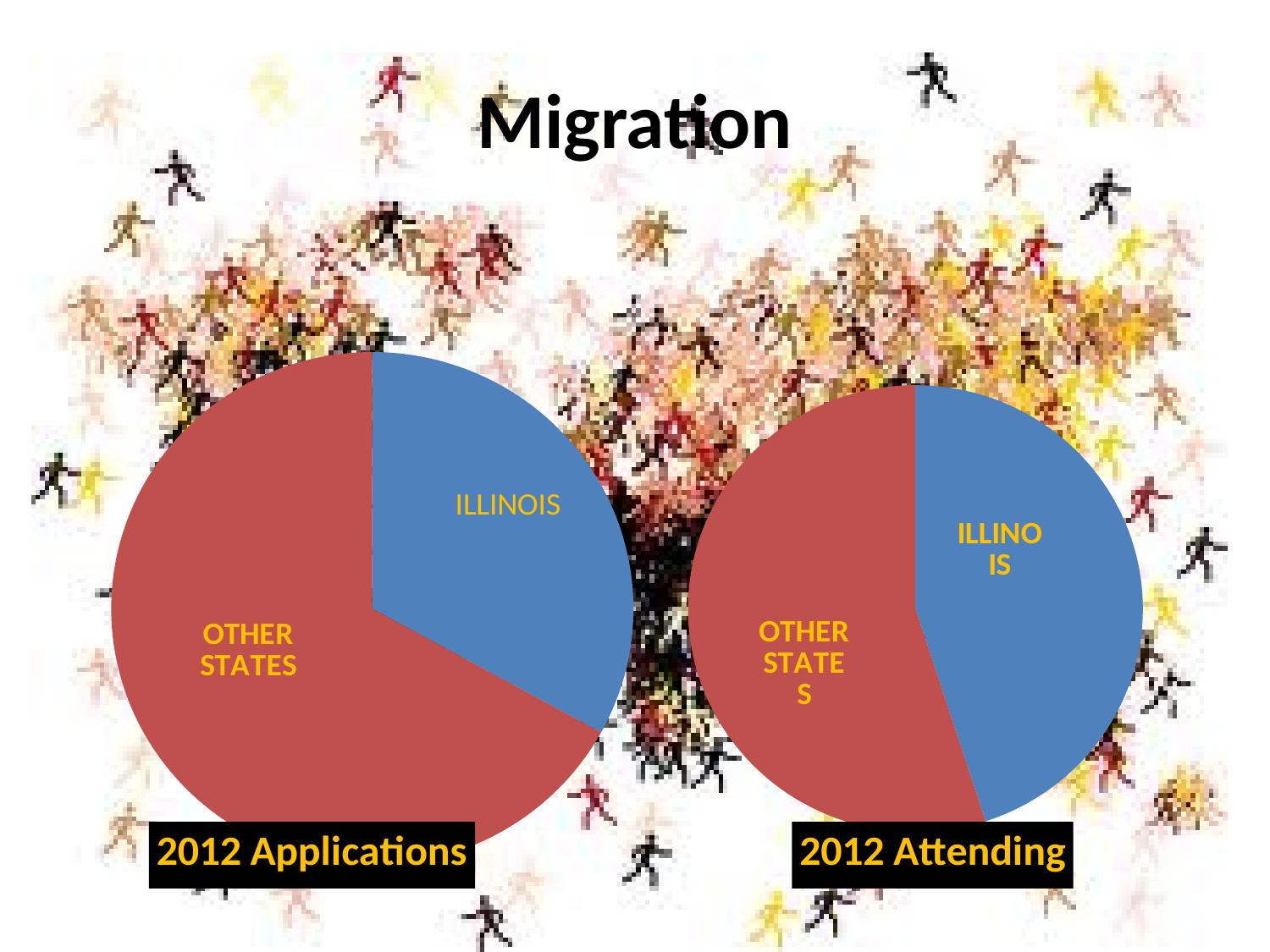
What kind of chart is the 2012 Applications chart? pie chart How many slices does the 2012 Applications pie chart have? 2 What colour is the ILLINOIS slice in the 2012 Attending pie chart? blue What is the title of the slide containing the two pie charts? Migration In the 2012 Applications pie chart, which is larger: the ILLINOIS slice or the OTHER STATES slice? OTHER STATES How many pie charts are shown on the slide? 2 In the 2012 Applications pie chart, which slice is the largest? OTHER STATES How many slices does the 2012 Attending pie chart have? 2 In the 2012 Attending pie chart, which slice is the largest? OTHER STATES In the 2012 Attending pie chart, which slice is the smallest? ILLINOIS What kind of chart is the 2012 Attending chart? pie chart In the 2012 Applications pie chart, which slice is the smallest? ILLINOIS